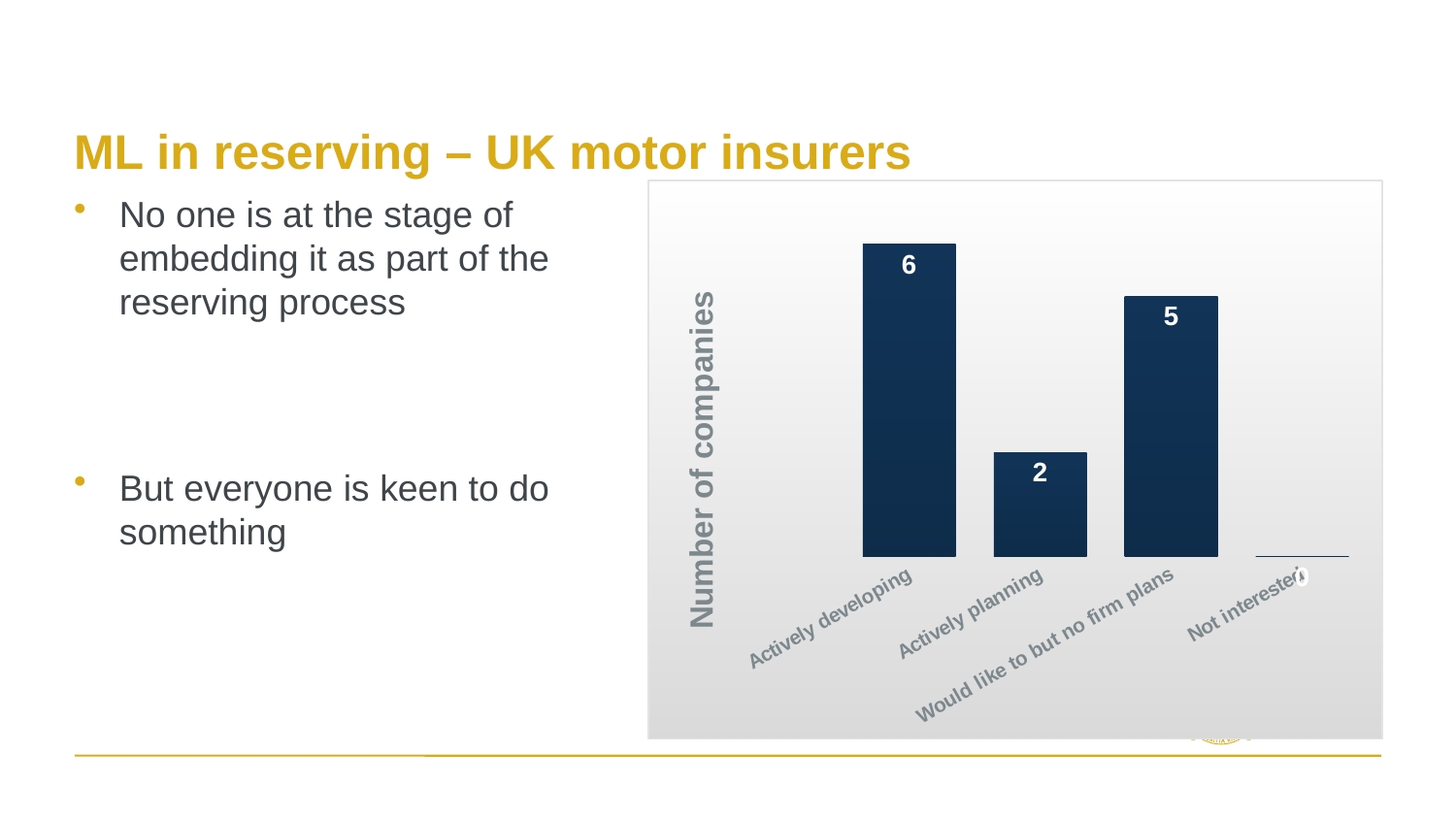
What kind of chart is shown on the slide? bar chart Which is larger, the value for 'Actively developing' or the value for 'Would like to but no firm plans'? Actively developing What is the label of the vertical axis of the chart? Number of companies What is the value for 'Actively planning'? 2 How many categories are shown on the x axis of the chart? 4 Which category has the highest number of companies? Actively developing What is the difference between the values for 'Actively developing' and 'Actively planning'? 4 What is the difference between the values for 'Would like to but no firm plans' and 'Actively planning'? 3 How many companies are in the 'Actively developing' category? 6 Which category has the lowest number of companies? Not interested What is the value for 'Would like to but no firm plans'? 5 What colour are the bars in the chart? dark navy blue